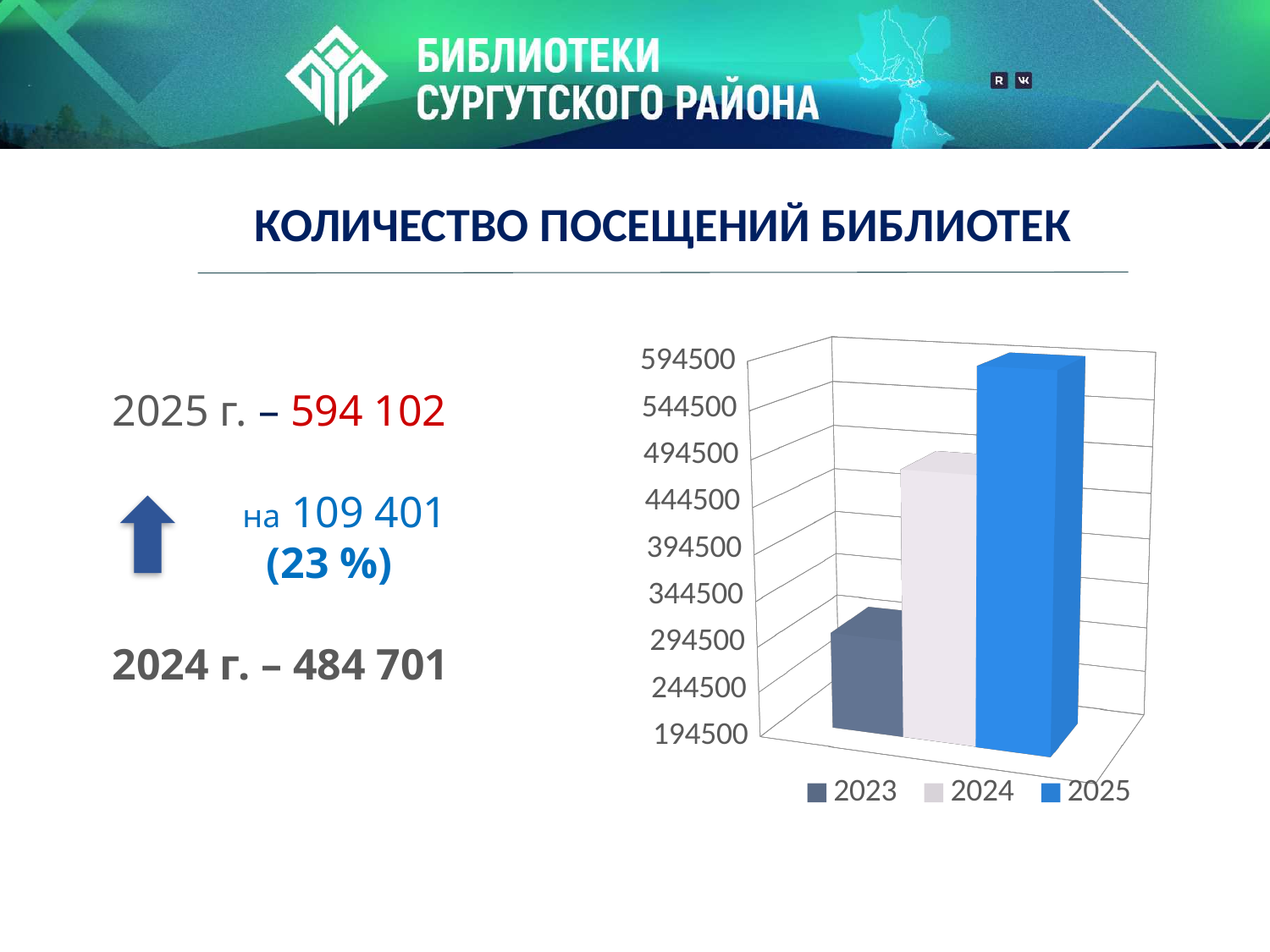
What is the number of library visits for 2024? 484 701 Is the value for 2023 greater or less than 394500? less Which is larger, the value for 2024 or the value for 2023? 2024 Which year has the highest number of library visits in the chart? 2025 How many bars are plotted in the chart? 3 What kind of chart is shown on the slide? bar chart What is the number of library visits for 2025? 594 102 How many series does the chart legend list? 3 What colour is the bar for 2025 in the chart? blue Which year has the lowest number of library visits in the chart? 2023 By how much did the number of library visits increase from 2024 to 2025? 109 401 Do the values rise or fall from 2023 to 2025? rise